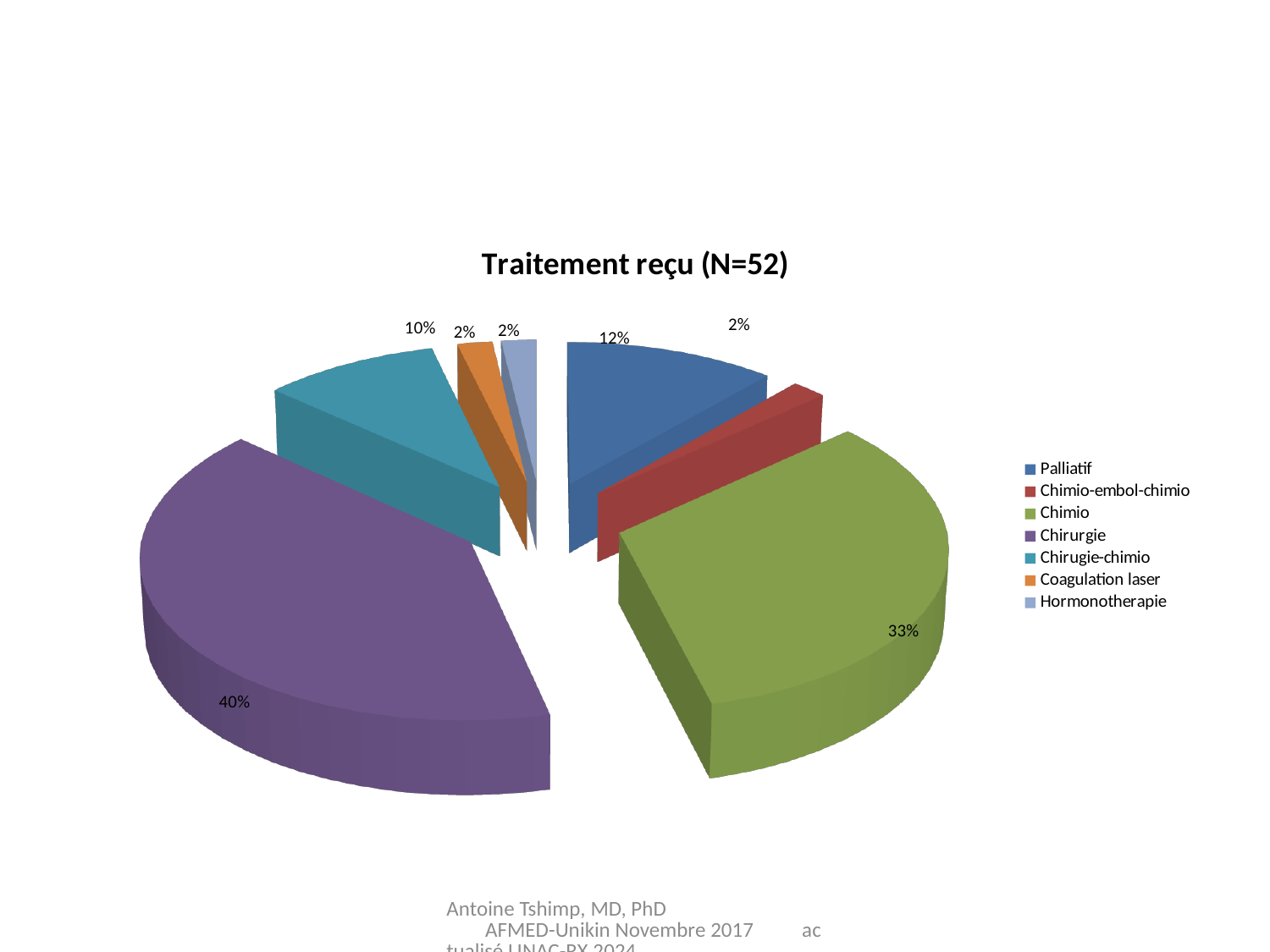
What percentage of the pie does Chirugie-chimio represent? 10% What percentage of the pie does Coagulation laser represent? 2% What is the difference in percentage points between Chirurgie and Chimio? 7 What is the title of the chart? Traitement reçu (N=52) Which treatment category has the largest share of the pie? Chirurgie What percentage of the pie does Chirurgie represent? 40% What is the difference in percentage points between Palliatif and Hormonotherapie? 10 What percentage of the pie does Palliatif represent? 12% Which is larger, the share for Palliatif or the share for Chirugie-chimio? Palliatif How many categories does the legend list? 7 What type of chart is shown on the slide? Pie chart What percentage of the pie does Chimio represent? 33%